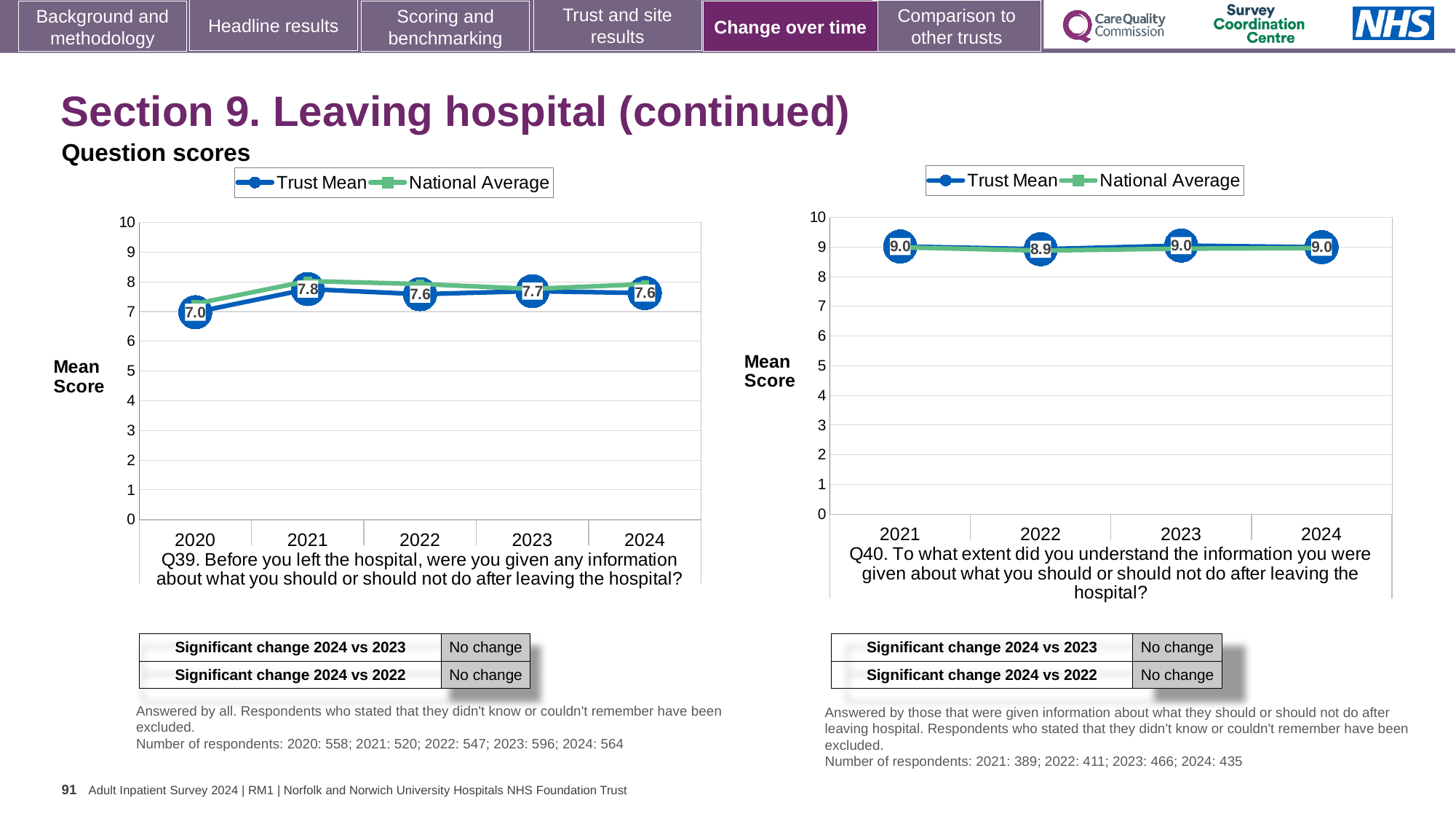
In the Q39 chart on the left, does the Trust Mean score rise or fall from 2020 to 2021? Rise In the Q40 chart on the right, which is larger: the Trust Mean score for 2021 or for 2022? 2021 In the Q39 chart on the left, is the Trust Mean score for 2020 greater or less than 8? less In the Q39 chart on the left, which year has the lowest Trust Mean score? 2020 In the Q39 chart on the left, what is the difference between the Trust Mean scores for 2021 and 2020? 0.8 In the Q40 chart on the right, what is the Trust Mean score for 2022? 8.9 In the Q39 chart on the left, what is the Trust Mean score for 2020? 7.0 In the Q39 chart on the left, what is the Trust Mean score for 2024? 7.6 How many years are plotted in the Q40 chart on the right? 4 How many series does the legend of the Q39 chart on the left list? 2 What type of chart is the Q40 chart on the right? Line chart In the Q39 chart on the left, which year has the highest Trust Mean score? 2021